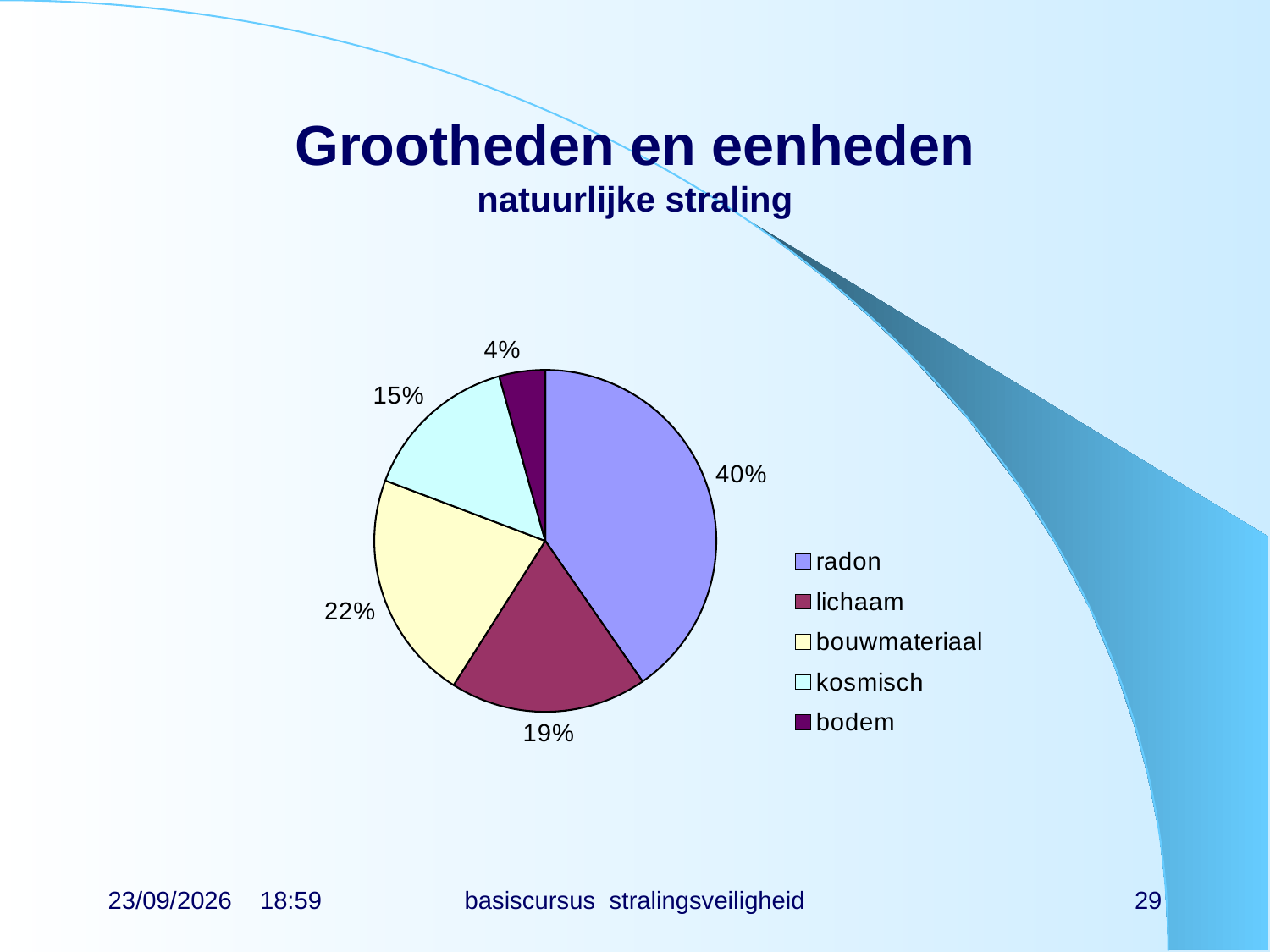
Which category has the smallest slice of the pie? bodem Which category is shown in yellow in the pie chart? bouwmateriaal Which category has the largest slice of the pie? radon Which is larger, the share for lichaam or the share for kosmisch? lichaam What share of the pie does bodem have? 4% What share of the pie does lichaam have? 19% What share of the pie does radon have? 40% How many slices does the pie chart have? 5 What is the difference in percentage points between radon and bouwmateriaal? 18 What kind of chart is shown on the slide? pie chart